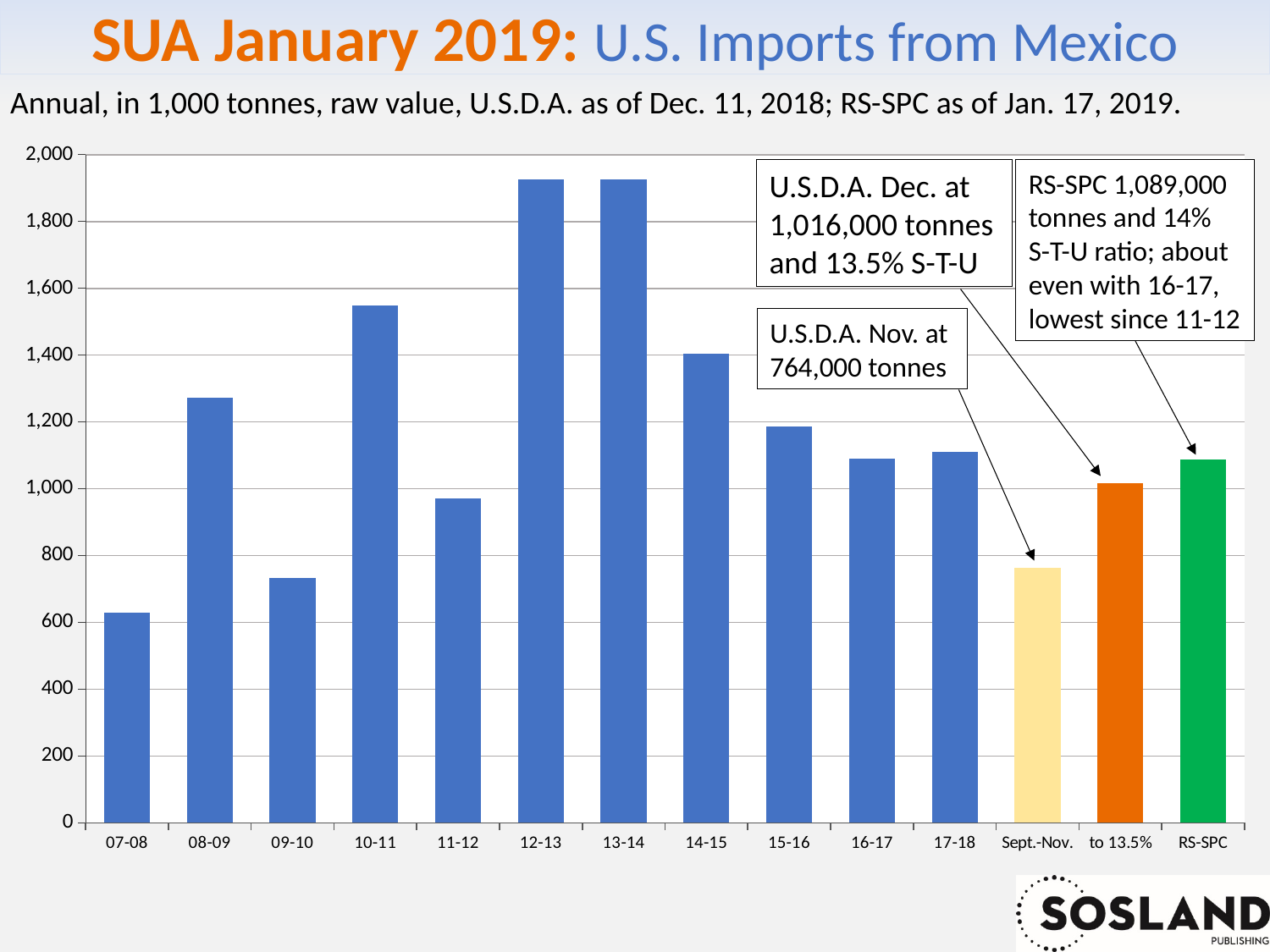
What is the difference between the RS-SPC value and the U.S.D.A. December value? 73,000 tonnes According to the callout, what is the RS-SPC value? 1,089,000 tonnes Is the value for 10-11 greater or less than 1,400? greater Is the value for 09-10 greater or less than 800? less Which year has the lowest value in the chart? 07-08 What is the difference between the U.S.D.A. December value and the U.S.D.A. November value? 252,000 tonnes What colour is the RS-SPC bar? green How many bars are plotted in the chart? 14 According to the callout, what is the U.S.D.A. November value for the Sept.-Nov. bar? 764,000 tonnes According to the callout, what is the U.S.D.A. December value for the 'to 13.5%' bar? 1,016,000 tonnes What type of chart is shown on the slide? bar chart Which is larger, the value for 10-11 or the value for 08-09? 10-11